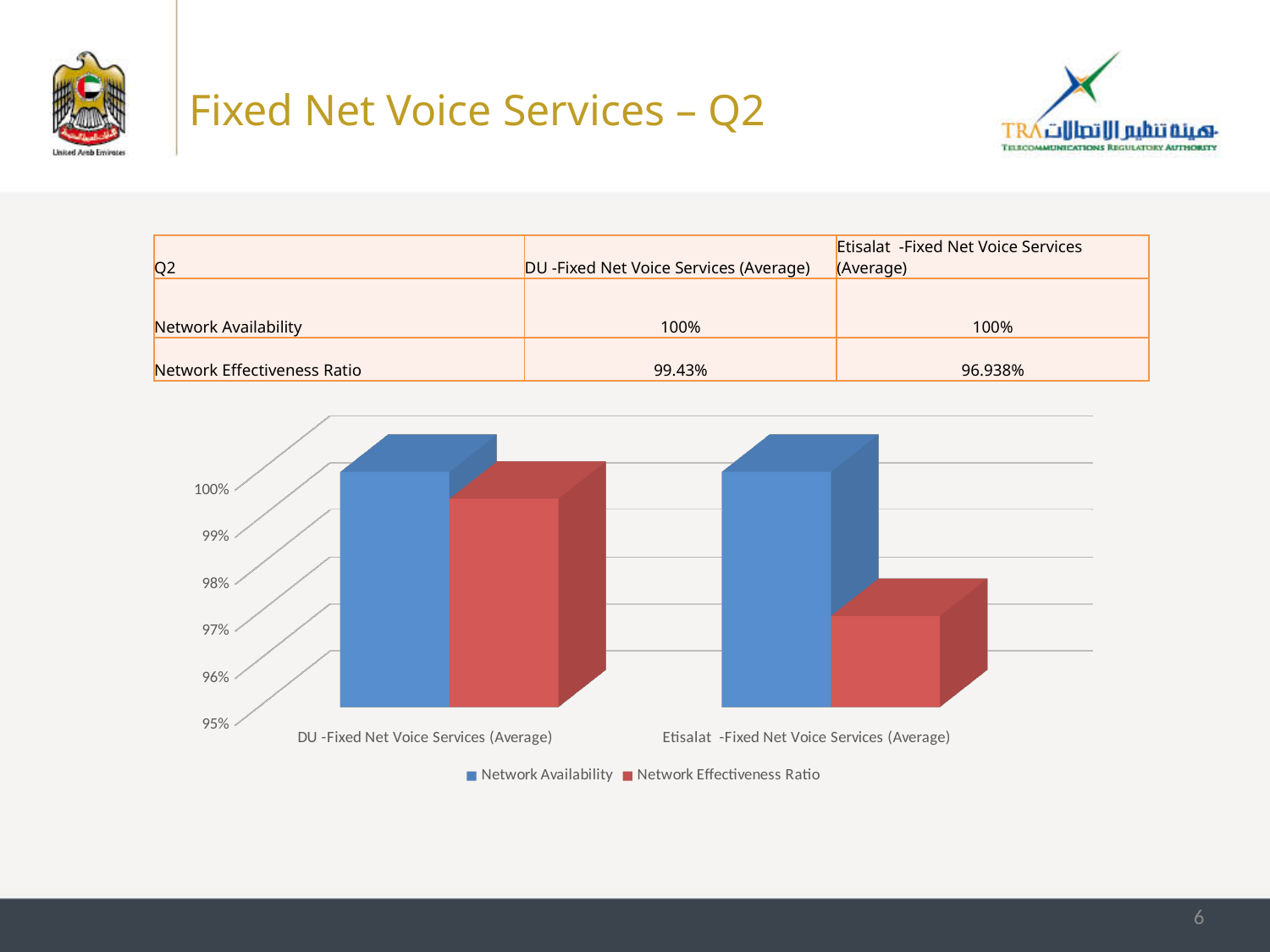
How many series does the chart legend list? 2 Which operator has the lower Network Effectiveness Ratio? Etisalat - Fixed Net Voice Services (Average) What kind of chart is shown on the slide? bar chart How many categories are shown on the x axis of the chart? 2 Is the Network Effectiveness Ratio for Etisalat greater or less than 98%? less What is the Network Availability value for Etisalat - Fixed Net Voice Services (Average)? 100% Is the Network Effectiveness Ratio for DU larger or smaller than that for Etisalat? larger Which series is shown in red in the chart? Network Effectiveness Ratio What is the Network Availability value for DU - Fixed Net Voice Services (Average)? 100% What is the difference between the Network Effectiveness Ratio of DU and that of Etisalat? 2.492% What is the Network Effectiveness Ratio for DU - Fixed Net Voice Services (Average)? 99.43% What is the Network Effectiveness Ratio for Etisalat - Fixed Net Voice Services (Average)? 96.938%